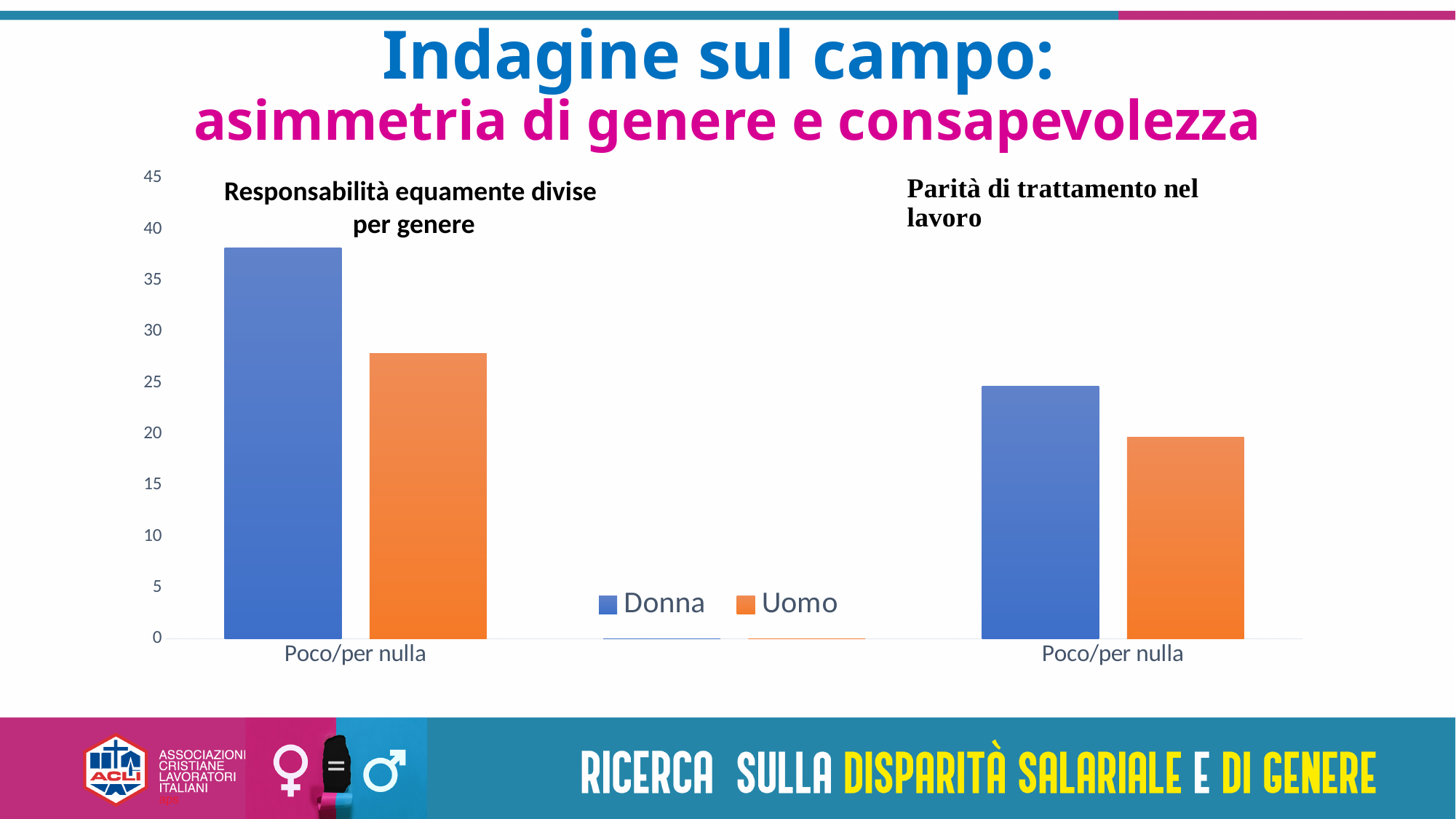
What are the two series named in the legend? Donna and Uomo What kind of chart is shown on the slide? bar chart Which bar is the shortest in the whole chart? Uomo, Parità di trattamento nel lavoro In the 'Parità di trattamento nel lavoro' group, which is larger, Donna or Uomo? Donna In the 'Responsabilità equamente divise per genere' group, is the value for Donna greater or less than 35? greater How many series does the legend list? 2 In the 'Parità di trattamento nel lavoro' group, is the value for Donna greater or less than 30? less In the 'Responsabilità equamente divise per genere' group, is the value for Uomo greater or less than 25? greater Which colour represents Uomo in the chart? orange Which bar is the tallest in the whole chart? Donna, Responsabilità equamente divise per genere In the 'Responsabilità equamente divise per genere' group, which is larger, Donna or Uomo? Donna